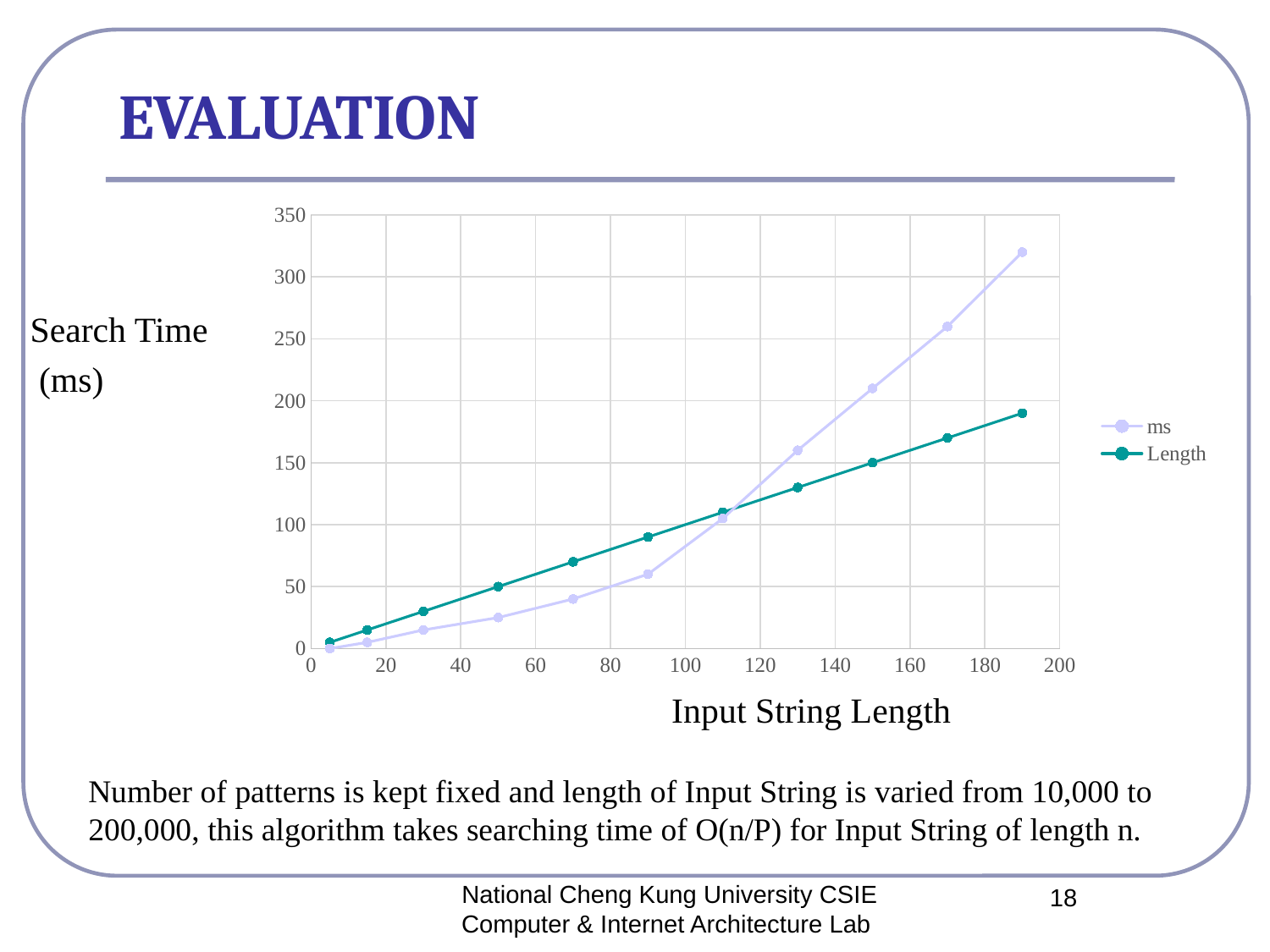
Is the value of the Length series at its rightmost point greater or less than 200? less How many data points are plotted for the Length series? 11 Do the values of the ms series rise or fall as Input String Length increases? rise At the rightmost data point, which series has the higher value, ms or Length? ms What kind of chart is shown on the slide? line chart What are the two series named in the legend? ms and Length Is the value of the ms series at its rightmost point greater or less than 300? greater What is the highest value shown on the y axis? 350 Do the values of the Length series rise or fall as Input String Length increases? rise How many series does the legend list? 2 What is the label of the x axis? Input String Length At the leftmost data points (near Input String Length 0), which series has the higher value, ms or Length? Length